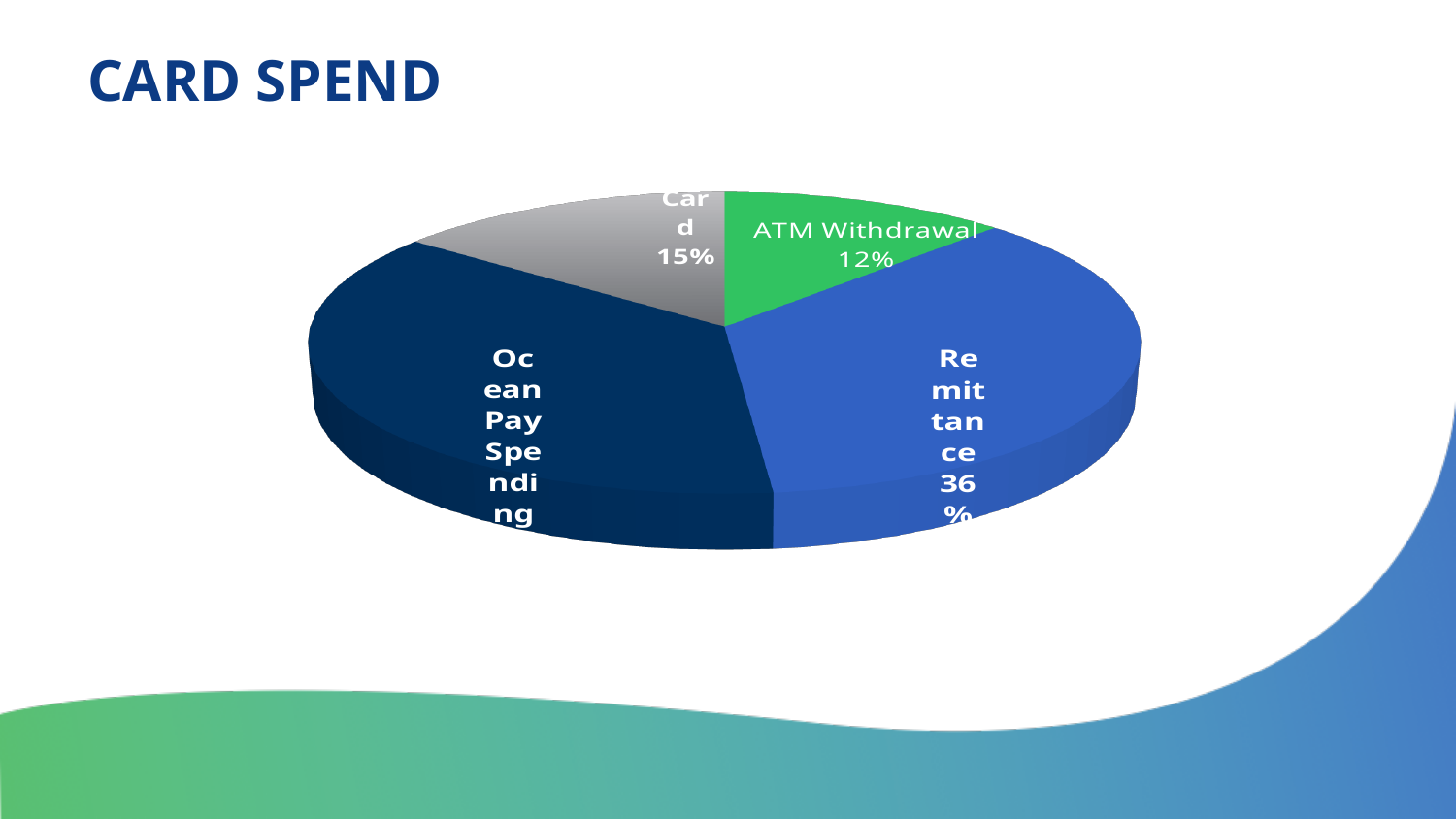
What percentage is shown for ATM Withdrawal? 12% What kind of chart is shown on the slide? pie chart Which labelled slice has the smallest percentage? ATM Withdrawal What is the difference in percentage points between Remittance and Card? 21% What percentage is shown for Card? 15% Which is larger, ATM Withdrawal or Card? Card How many slices does the pie chart have? 4 What colour is the ATM Withdrawal slice? green What share of card spend is Remittance? 36% What is the title of the chart? CARD SPEND What is the difference in percentage points between Card and ATM Withdrawal? 3% Which is larger, Remittance or Card? Remittance